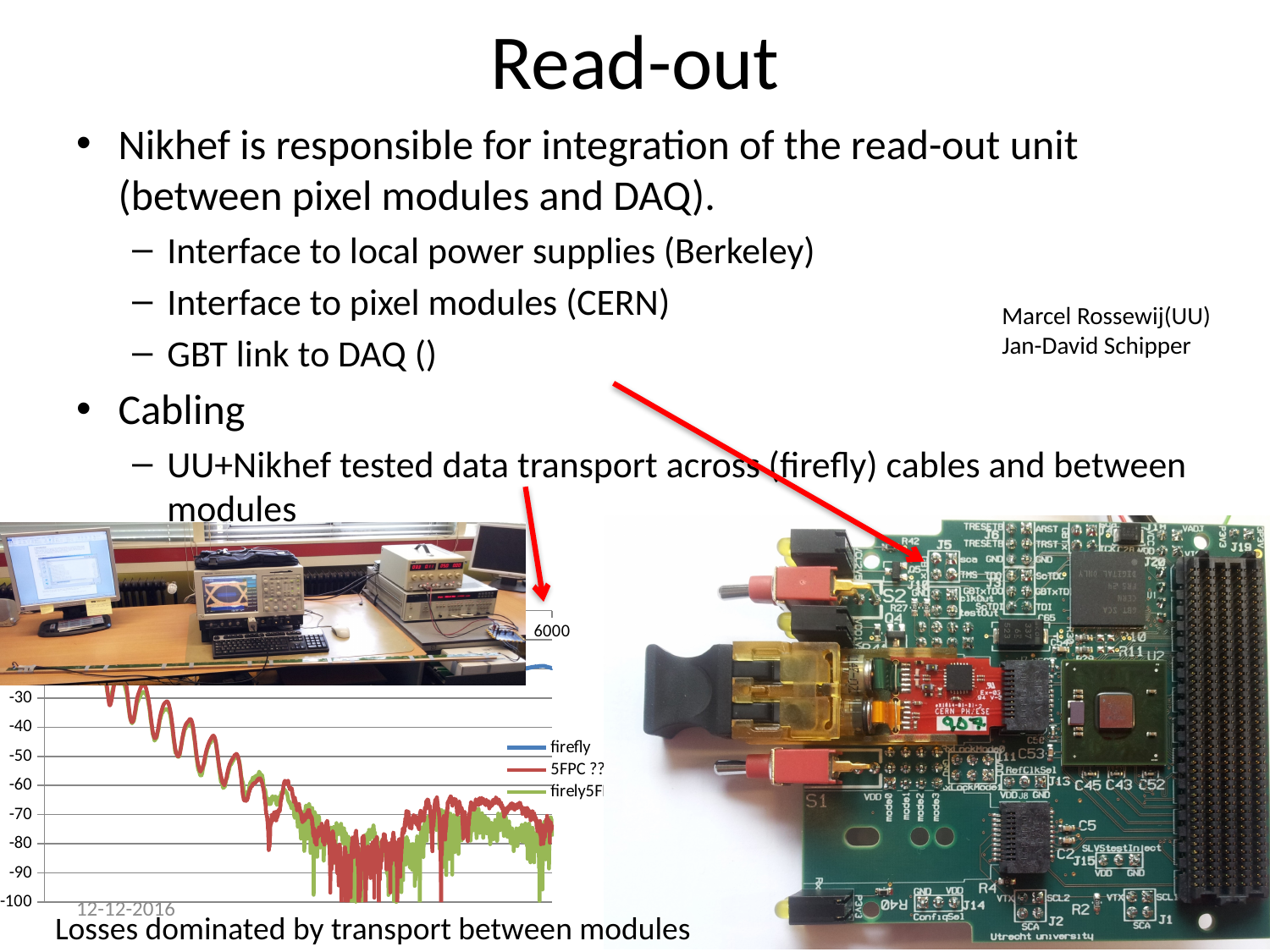
What is the first entry in the legend of the line chart? firefly Do the values in the line chart rise or fall along the x axis? fall How many series does the legend of the line chart list? 3 What kind of chart is shown at the bottom left of the slide? line chart What colour is the line for the "5FPC ??" series in the line chart? red